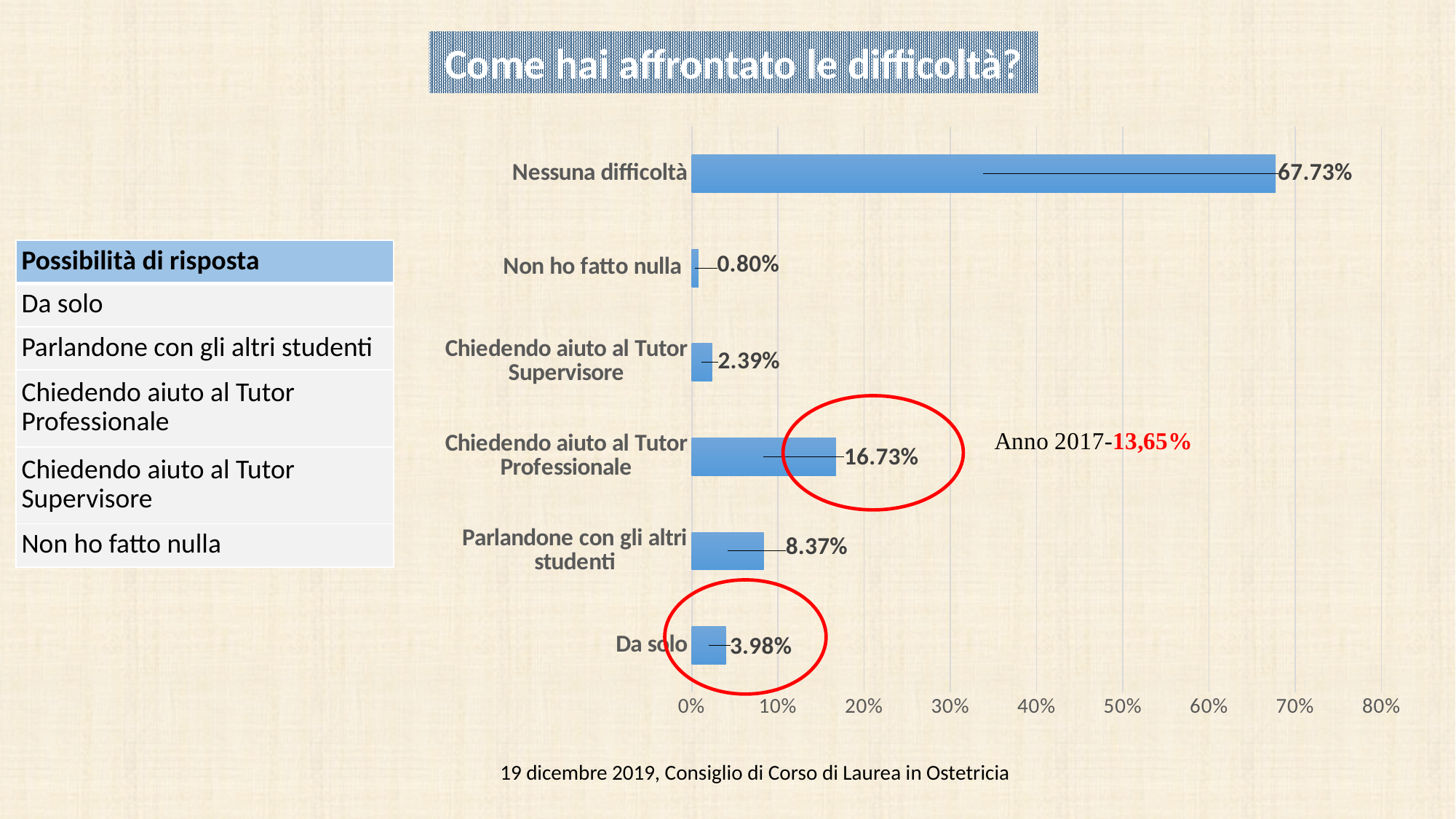
What kind of chart is shown on the slide? bar chart Is the value for "Nessuna difficoltà" greater or less than 60%? greater What is the value for "Chiedendo aiuto al Tutor Professionale"? 16.73% Which category has the highest value? Nessuna difficoltà Which category has the lowest value? Non ho fatto nulla What is the value for "Non ho fatto nulla"? 0.80% What is the value for "Da solo"? 3.98% Which is larger: "Da solo" or "Chiedendo aiuto al Tutor Supervisore"? Da solo What is the title of the chart? Come hai affrontato le difficoltà? What is the value for "Nessuna difficoltà"? 67.73% What is the difference between "Chiedendo aiuto al Tutor Professionale" and "Parlandone con gli altri studenti"? 8.36% How many categories are shown in the chart? 6